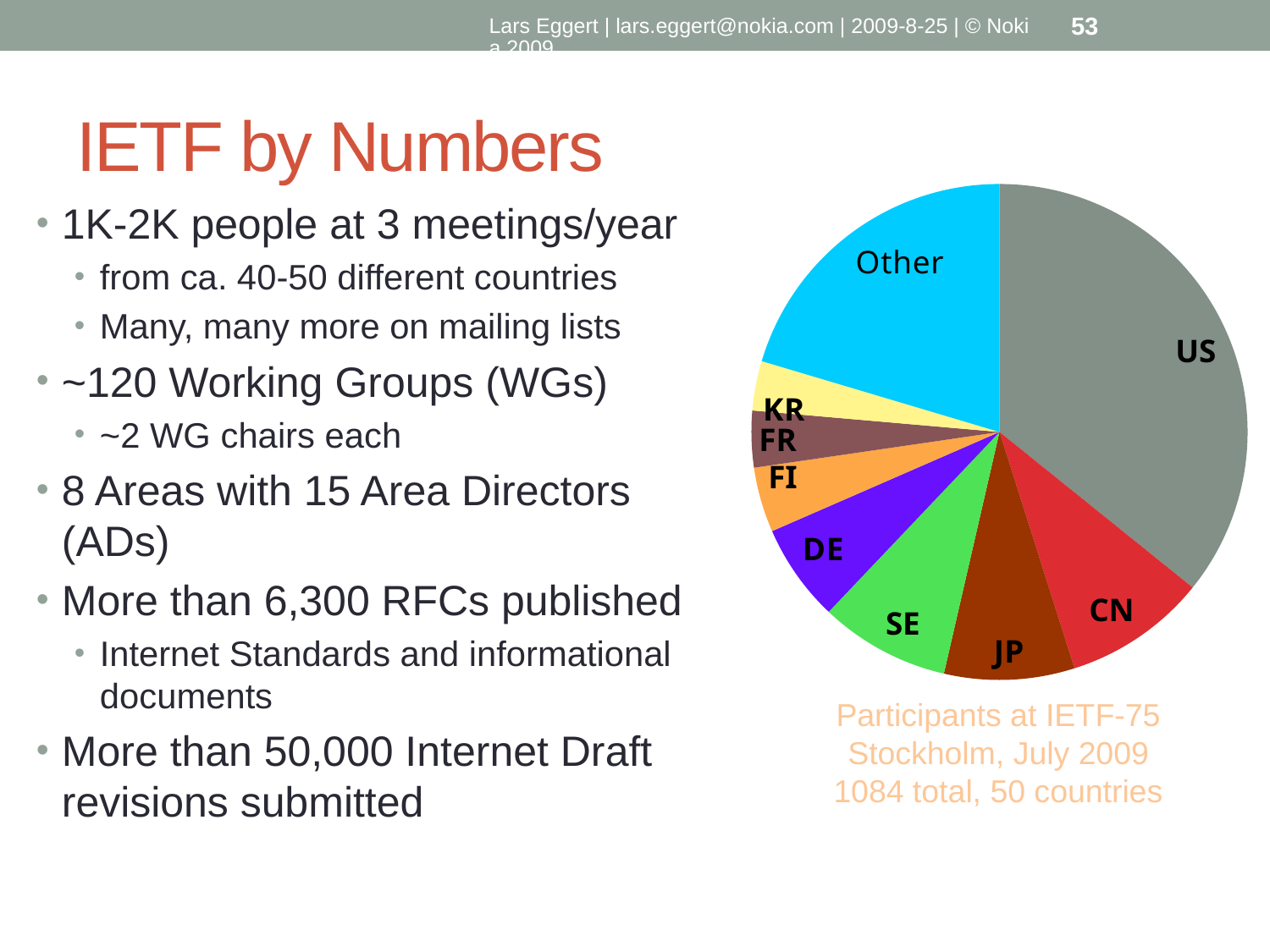
How many labeled slices does the pie chart have? 9 Which is larger in the pie chart, the DE slice or the KR slice? DE According to the caption, what is the total number of participants shown in the pie chart? 1084 What kind of chart is shown on the slide? pie chart Apart from US, which labeled slice of the pie chart is the largest? Other Which is larger in the pie chart, the US slice or the CN slice? US According to the caption, which meeting does the pie chart show participants for? IETF-75 Stockholm, July 2009 Which country has the largest slice of the pie chart? US